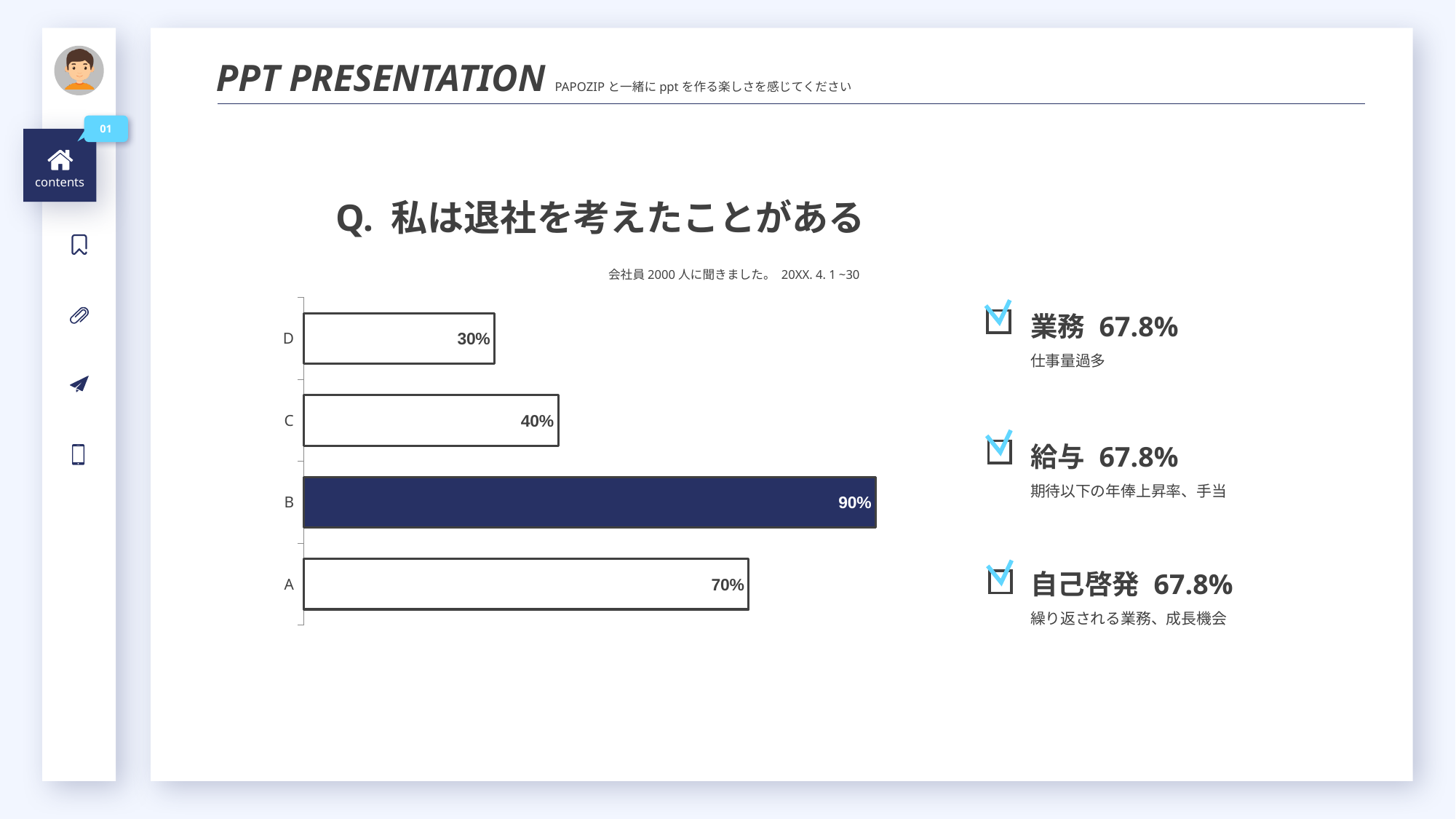
Which category has the lowest value? D How many categories are shown in the chart? 4 What is the value for category B? 90% Which category has the highest value? B What is the difference between the values for C and D? 10% Which is larger, the value for A or the value for C? A What is the value for category D? 30% What is the value for category C? 40% Which bar is filled with a dark colour rather than white? B What is the difference between the values for B and A? 20% What is the value for category A? 70% What kind of chart is shown on the slide? Bar chart